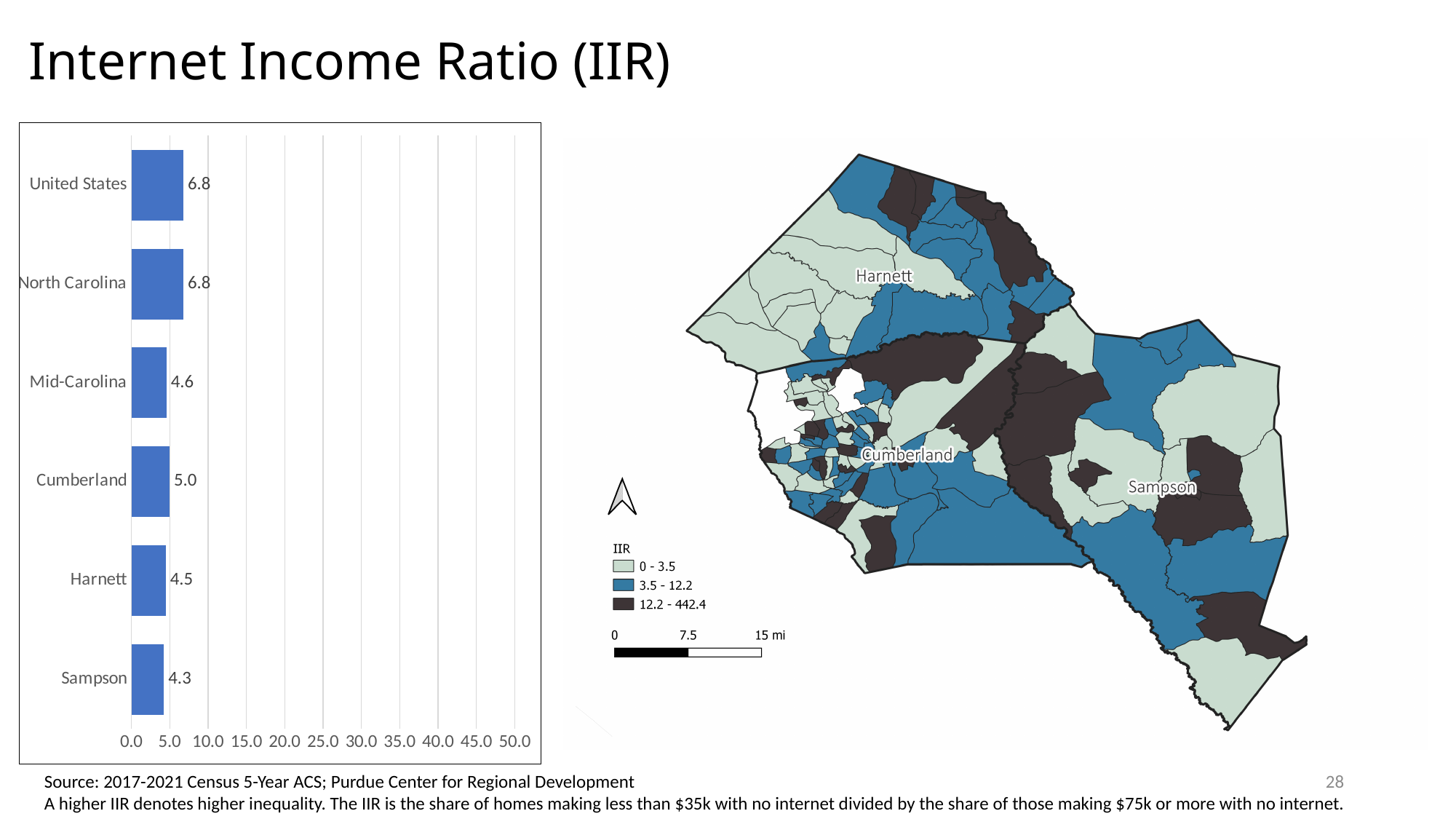
How many IIR ranges does the map legend list? 3 In the bar chart, which is larger: the value for Cumberland or the value for Harnett? Cumberland What is the IIR value for North Carolina in the bar chart? 6.8 What is the IIR value for Mid-Carolina in the bar chart? 4.6 In the bar chart, what is the difference between the values for Cumberland and Sampson? 0.7 What kind of chart is shown on the left of the slide? bar chart What is the IIR value for Sampson in the bar chart? 4.3 In the bar chart, is the value for Cumberland greater or less than 10.0? less In the bar chart, what is the difference between the values for United States and Mid-Carolina? 2.2 What is the IIR value for Cumberland in the bar chart? 5.0 How many categories are shown in the bar chart? 6 Which category has the lowest value in the bar chart? Sampson